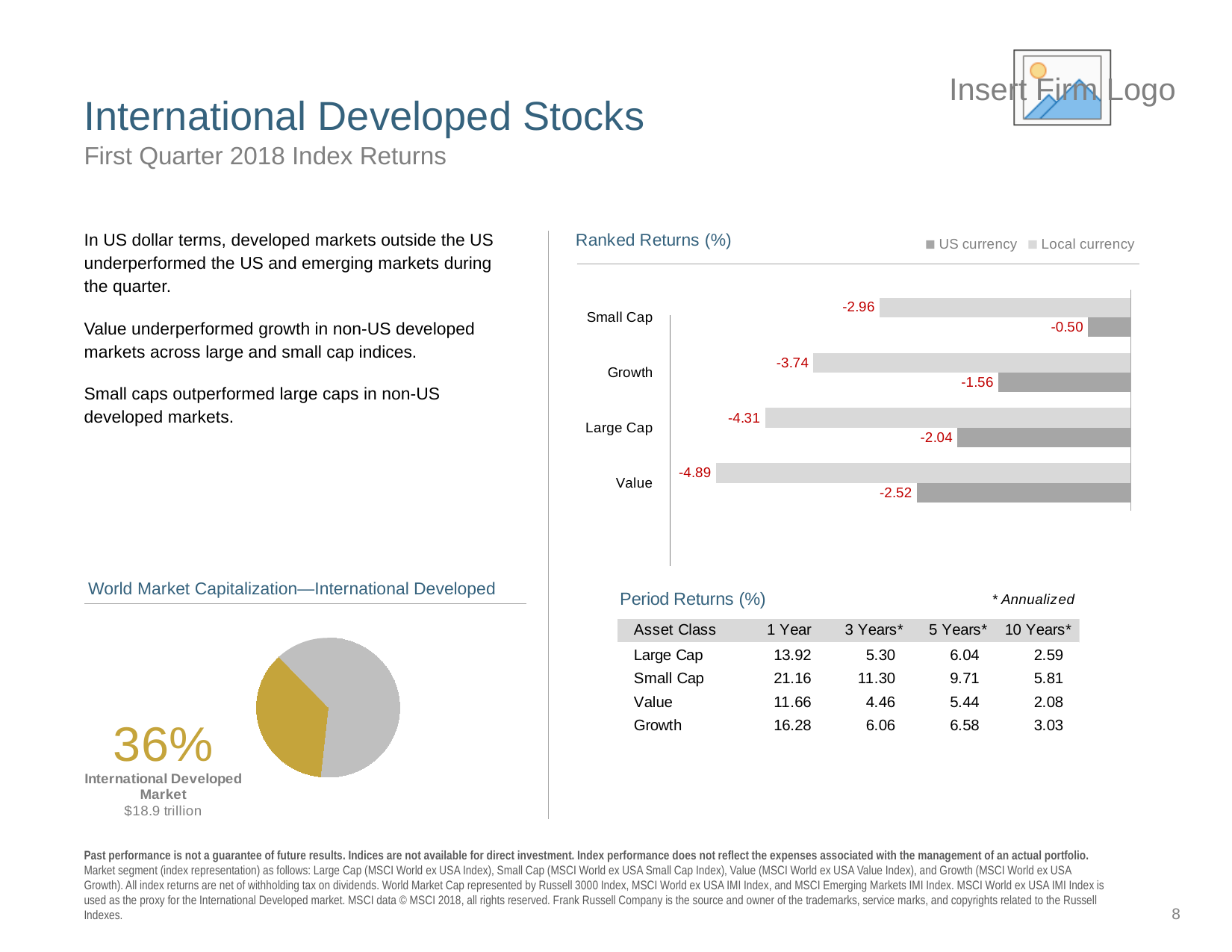
In the World Market Capitalization—International Developed pie chart, what share does the International Developed Market slice represent? 36% How many categories are shown in the Ranked Returns (%) chart? 4 In the Ranked Returns (%) chart, what is the difference between the US currency and Local currency returns for Large Cap? 2.27 In the Ranked Returns (%) chart, what is the US currency return for Small Cap? -0.50 In the Ranked Returns (%) chart, which is larger, the US currency return for Growth or the US currency return for Value? Growth In the Ranked Returns (%) chart, what is the US currency return for Large Cap? -2.04 In the Ranked Returns (%) chart, which category has the highest Local currency return? Small Cap What kind of chart is the Ranked Returns (%) chart? Bar chart In the Ranked Returns (%) chart, what is the Local currency return for Value? -4.89 In the Ranked Returns (%) chart, which category has the lowest US currency return? Value How many series does the legend of the Ranked Returns (%) chart list? 2 In the Ranked Returns (%) chart, what is the Local currency return for Growth? -3.74